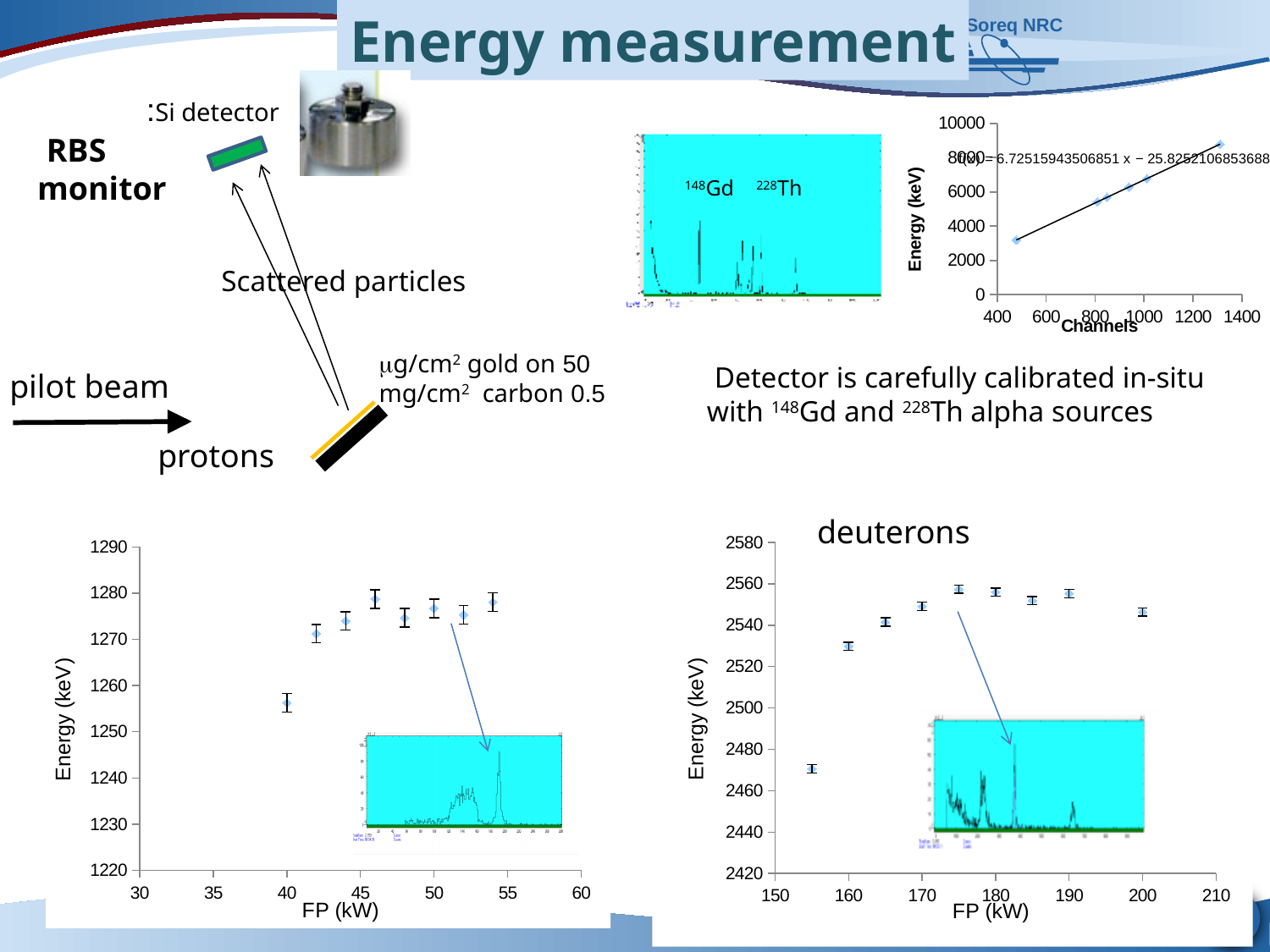
In the bottom-left chart of Energy (keV) versus FP (kW), is the energy at FP = 40 kW greater or less than 1260? less In the bottom-right chart titled 'deuterons', how many data points are plotted? 9 In the top-right chart of Energy (keV) versus Channels, is the energy of the highest-channel point (near channel 1300) greater or less than 8000? greater In the top-right chart of Energy (keV) versus Channels, is the energy of the lowest-channel point (near channel 480) greater or less than 4000? less In the bottom-right chart titled 'deuterons', which has the larger energy: the point at FP = 155 kW or the point at FP = 200 kW? 200 kW What is the x-axis label of the top-right calibration chart? Channels In the bottom-right chart titled 'deuterons', at which FP value is the energy lowest? 155 In the top-right chart of Energy (keV) versus Channels, do the energy values rise or fall as the channel number increases? rise In the bottom-left chart of Energy (keV) versus FP (kW), how many data points are plotted? 8 In the bottom-left chart of Energy (keV) versus FP (kW), at which FP value is the energy lowest? 40 What kind of chart is the top-right chart of Energy (keV) versus Channels? scatter chart with a fitted line